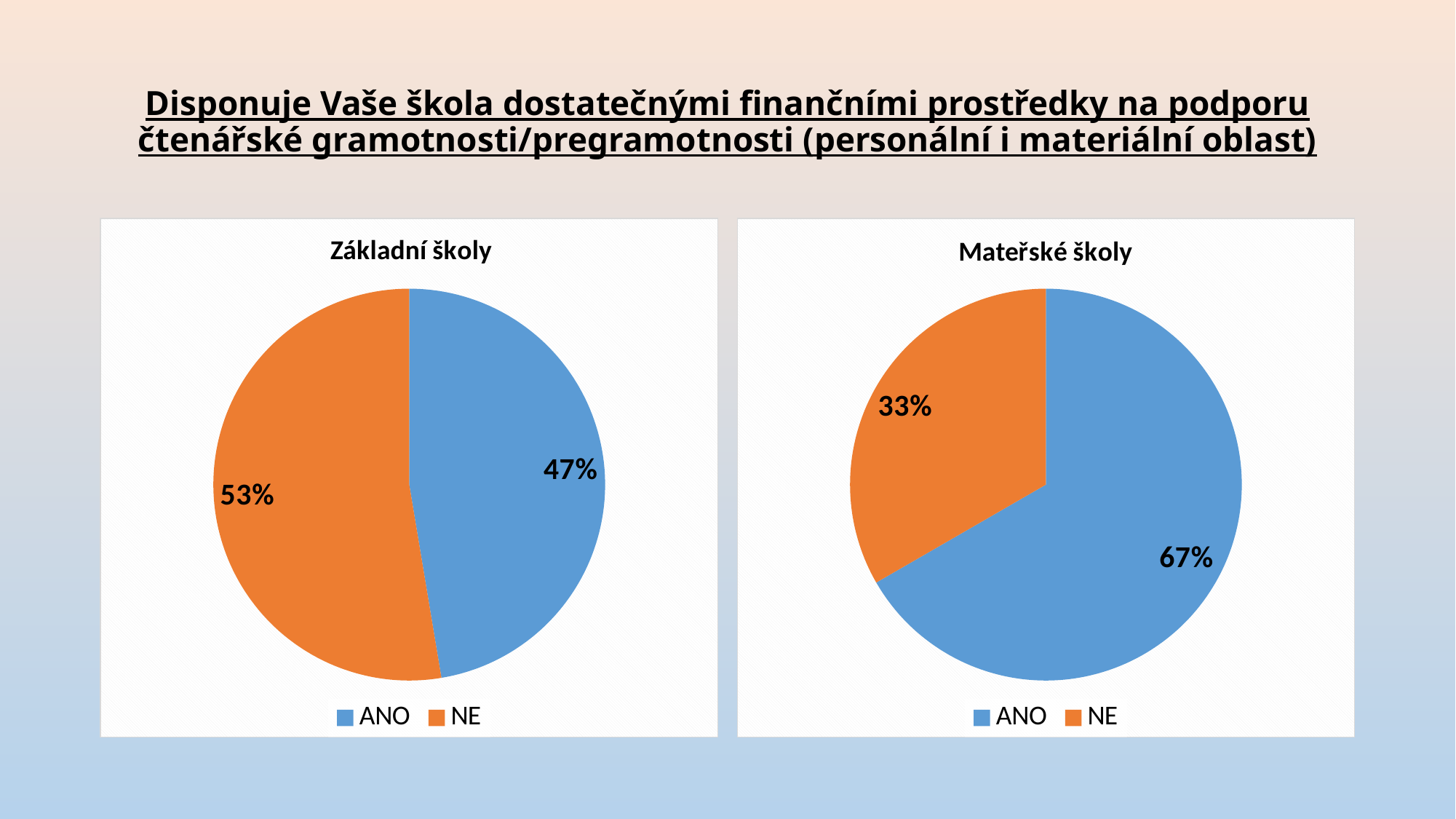
In the 'Mateřské školy' chart, which slice is the smallest? NE In the 'Mateřské školy' chart, what colour is the ANO slice? Blue In the 'Základní školy' chart, what share of the pie is ANO? 47% In the 'Základní školy' chart, what share of the pie is NE? 53% In the 'Mateřské školy' chart, what share of the pie is NE? 33% Which chart has the larger ANO share, 'Základní školy' or 'Mateřské školy'? Mateřské školy In the 'Základní školy' chart, which slice is the largest? NE What kind of chart is the 'Mateřské školy' chart? Pie chart How many slices does the 'Základní školy' pie chart have? 2 In the 'Základní školy' chart, what is the difference between the NE and ANO shares? 6% In the 'Mateřské školy' chart, what is the difference between the ANO and NE shares? 34%